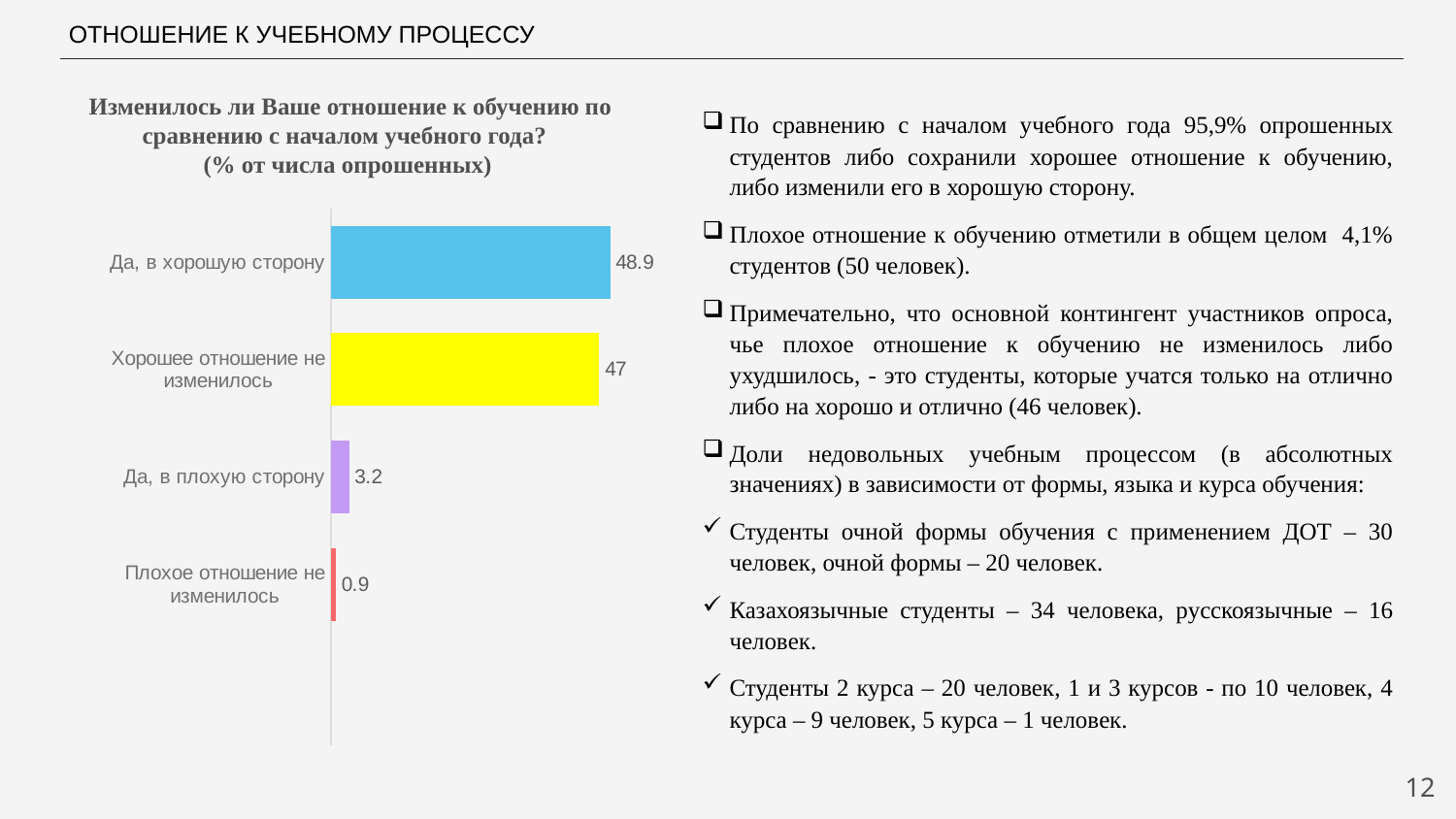
Which is larger: the value for "Да, в плохую сторону" or for "Плохое отношение не изменилось"? Да, в плохую сторону What value is shown for "Да, в хорошую сторону"? 48.9 What value is shown for "Плохое отношение не изменилось"? 0.9 What colour is the bar for "Хорошее отношение не изменилось"? Yellow What is the difference between the values for "Да, в хорошую сторону" and "Хорошее отношение не изменилось"? 1.9 Which category has the lowest value? Плохое отношение не изменилось What value is shown for "Хорошее отношение не изменилось"? 47 How many categories are shown in the chart? 4 What is the difference between the values for "Да, в плохую сторону" and "Плохое отношение не изменилось"? 2.3 Which category has the highest value? Да, в хорошую сторону What value is shown for "Да, в плохую сторону"? 3.2 What kind of chart is shown on the slide? Bar chart